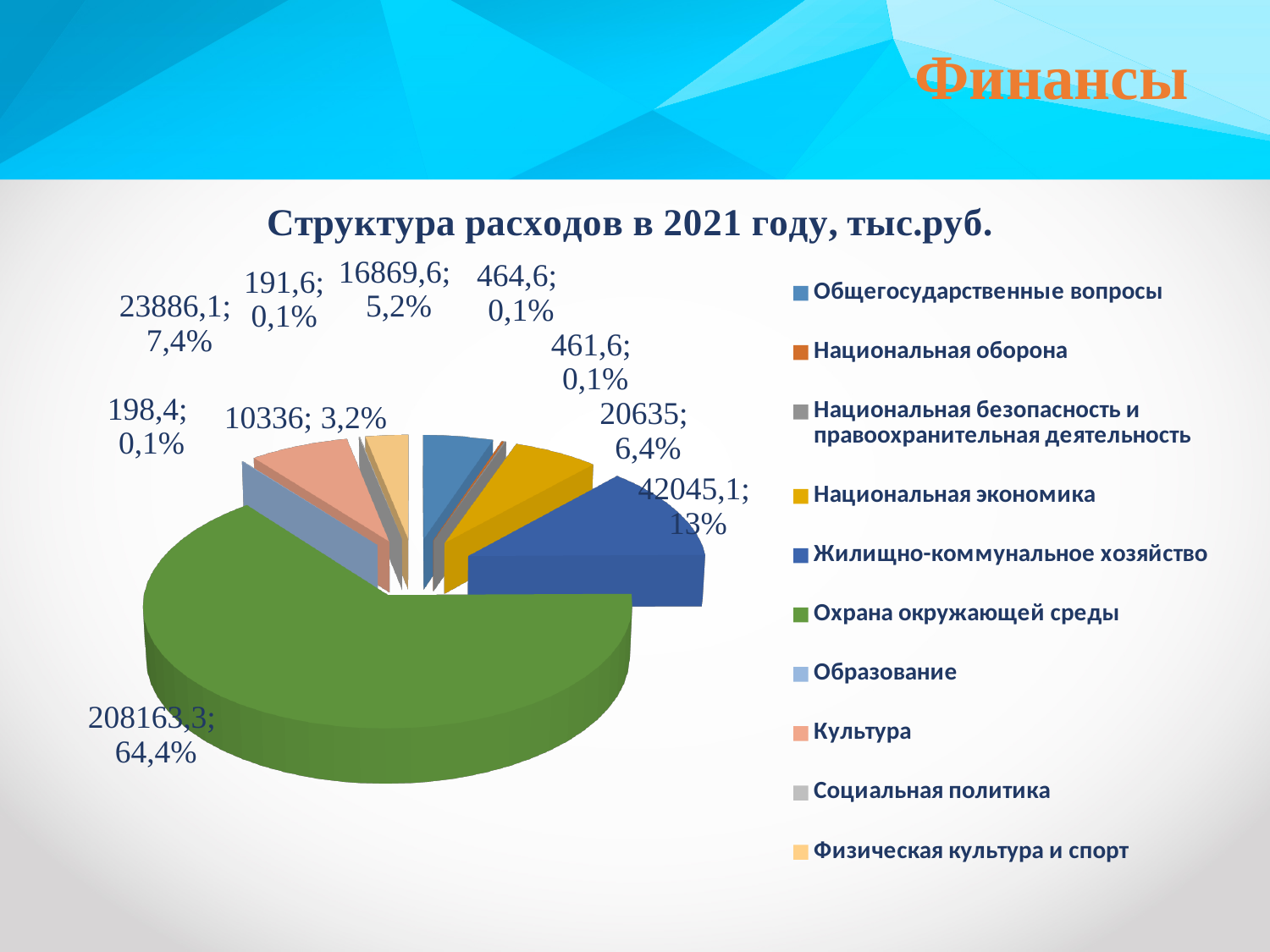
What is the value shown for Национальная экономика? 20635 What kind of chart is shown on the slide? pie chart What share of the pie does Жилищно-коммунальное хозяйство have? 13% How many categories does the legend of the pie chart list? 10 What is the difference between the values for Жилищно-коммунальное хозяйство and Национальная экономика? 21410,1 What share of the pie does Охрана окружающей среды have? 64,4% What is the title of the chart? Структура расходов в 2021 году, тыс.руб. What is the value shown for Жилищно-коммунальное хозяйство? 42045,1 Which category has the largest share of the pie? Охрана окружающей среды Which is larger, the value for Жилищно-коммунальное хозяйство or the value for Национальная экономика? Жилищно-коммунальное хозяйство What is the value shown for Охрана окружающей среды? 208163,3 What share of the pie does Общегосударственные вопросы have? 5,2%